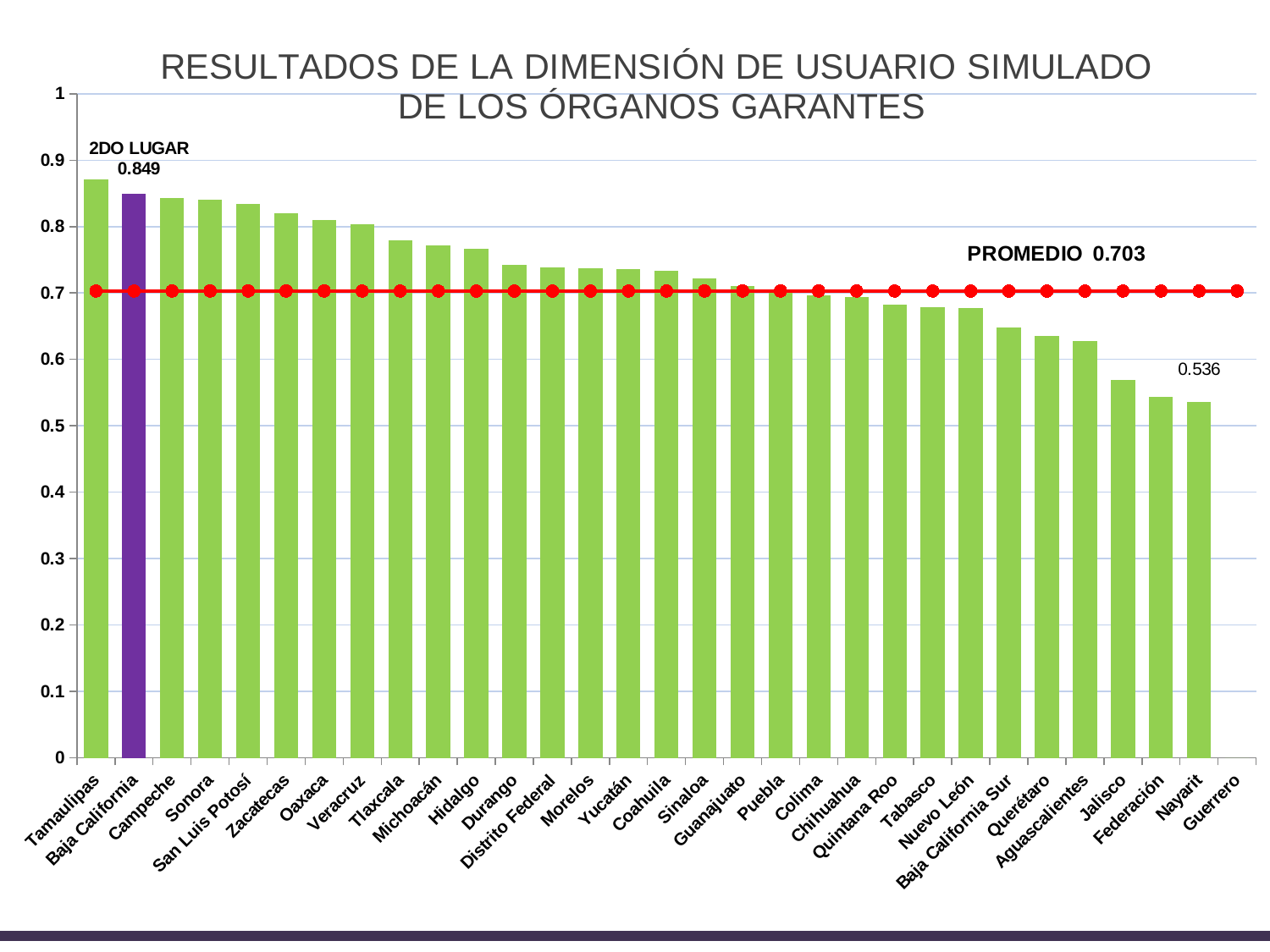
What label appears above the Baja California bar? 2DO LUGAR What is the value of the PROMEDIO line? 0.703 What is the difference between the values for Baja California and Guerrero? 0.849 Which category has the lowest value? Guerrero Is the value for Jalisco greater or less than 0.6? less What is the value for Guerrero? 0 Which has a larger value, Campeche or Veracruz? Campeche Is the value for Tamaulipas greater or less than 0.8? greater Do the bar values rise or fall from left to right along the x axis? fall Which category has the highest value? Tamaulipas What kind of chart is shown on the slide? bar chart What is the value for Baja California? 0.849